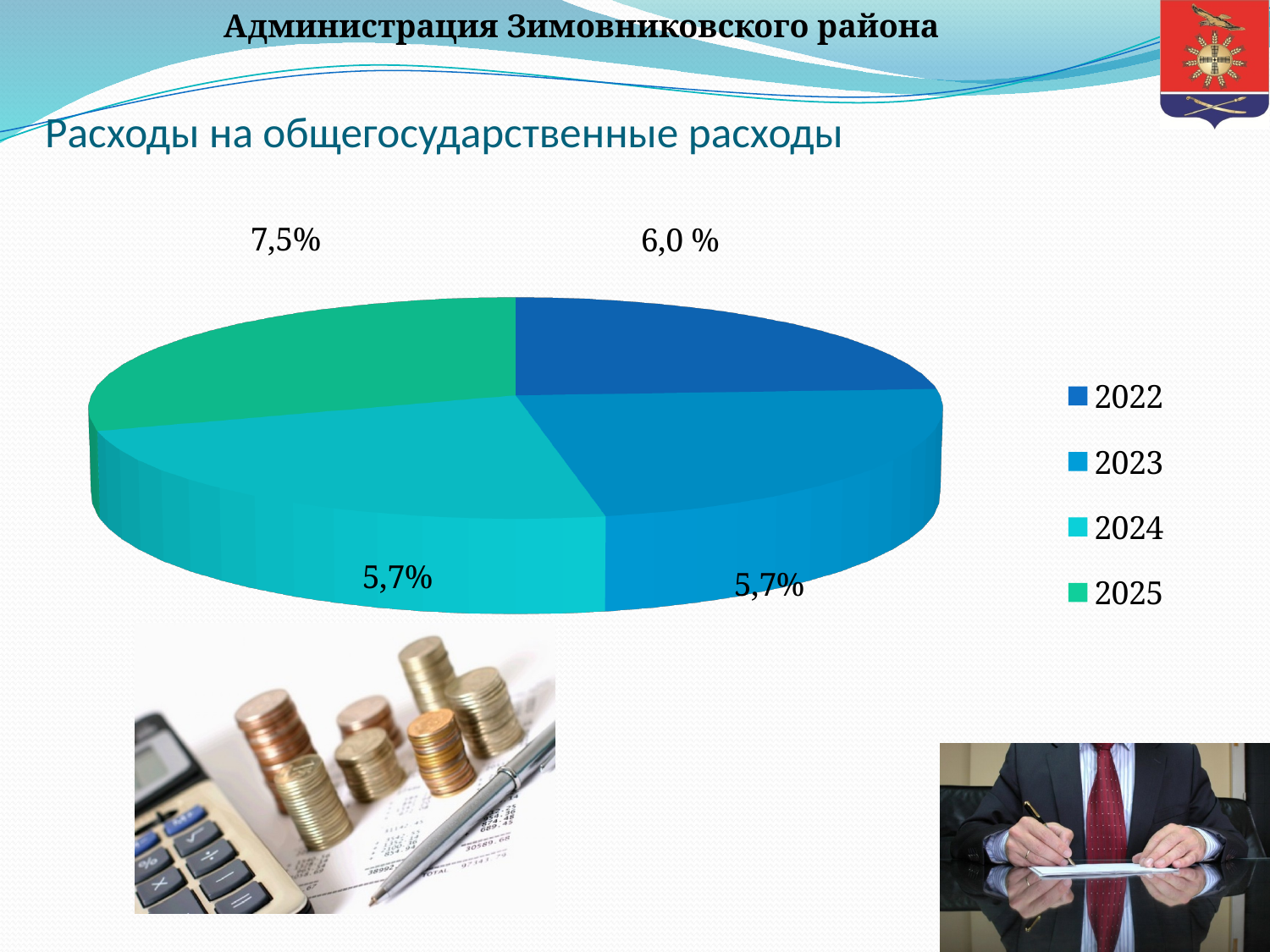
What type of chart is shown on the slide? pie chart What is the value shown for 2023 in the pie chart? 5,7% How many entries does the legend list? 4 Which is larger, the value for 2022 or the value for 2025? 2025 What is the value shown for 2022 in the pie chart? 6,0 % What is the value shown for 2024 in the pie chart? 5,7% Which year has the highest value in the pie chart? 2025 What is the value shown for 2025 in the pie chart? 7,5% What is the title of the chart on the slide? Расходы на общегосударственные расходы How many slices does the pie chart have? 4 What is the difference between the value for 2025 and the value for 2022? 1,5% Which year is shown in green in the legend? 2025